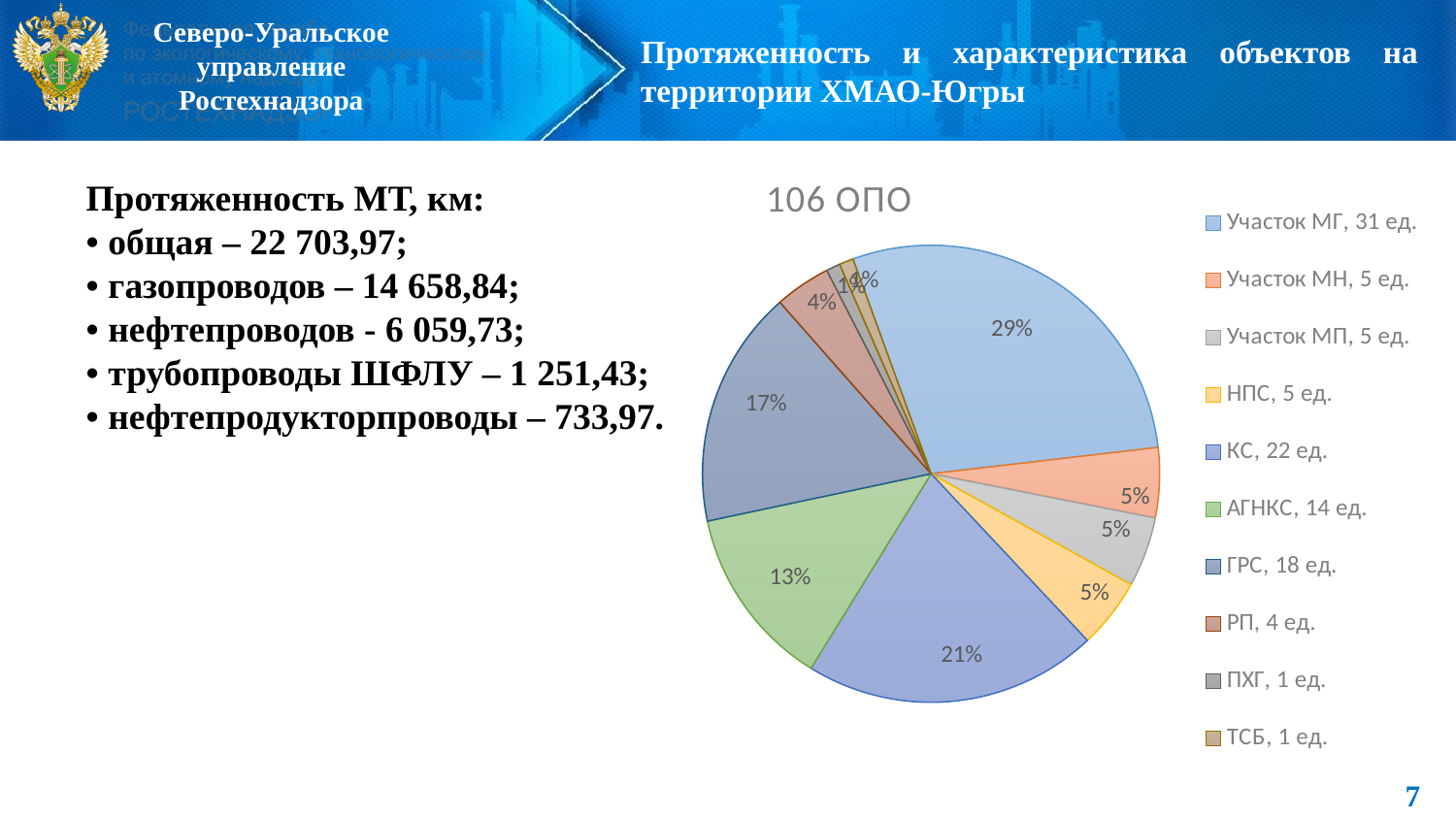
How many slices (categories) does the pie chart have? 10 What percentage share does the Участок МГ slice have? 29% How many units (ед.) does the legend give for КС? 22 ед. Which slice is larger, КС or ГРС? КС How many units (ед.) does the legend give for Участок МГ? 31 ед. What percentage share does the КС slice have? 21% Which category has the largest slice of the pie chart? Участок МГ What is the title of the pie chart? 106 ОПО What percentage share does the АГНКС slice have? 13% What is the difference in percentage points between the Участок МГ slice and the КС slice? 8% What kind of chart is shown on the slide? pie chart